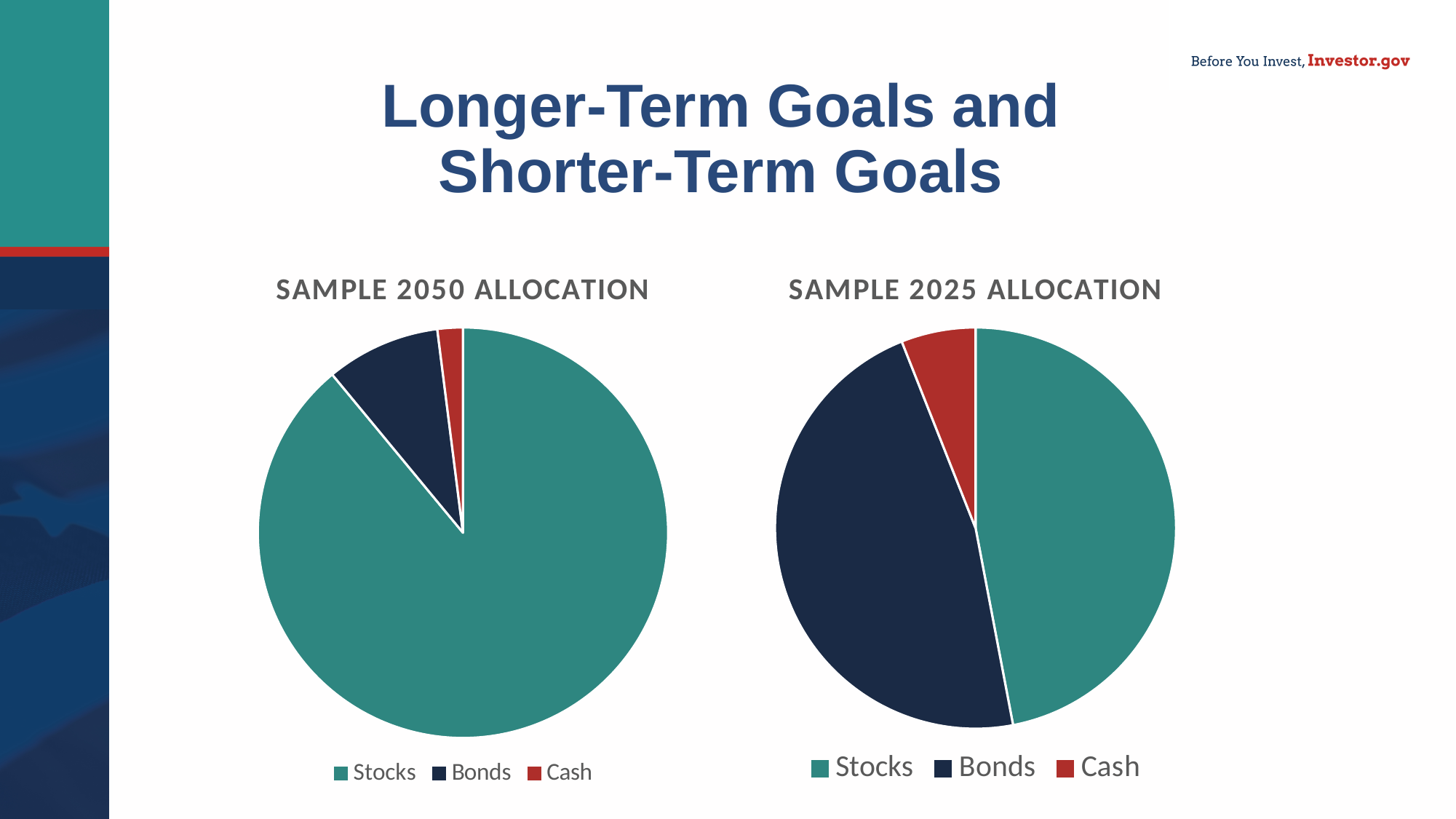
In the Sample 2050 Allocation chart, which category has the largest slice? Stocks Is the Bonds slice larger in the Sample 2050 Allocation chart or the Sample 2025 Allocation chart? Sample 2025 Allocation In the Sample 2050 Allocation chart, which category has the smallest slice? Cash In the Sample 2025 Allocation chart, which slice is larger: Bonds or Cash? Bonds How many categories are shown in the Sample 2050 Allocation pie chart? 3 In the Sample 2025 Allocation chart, which category has the smallest slice? Cash What type of chart is the Sample 2050 Allocation chart? Pie chart What type of chart is the Sample 2025 Allocation chart? Pie chart What colour represents Cash in both pie charts? Red How many entries does the legend of the Sample 2025 Allocation chart list? 3 What is the title of the pie chart on the left? SAMPLE 2050 ALLOCATION